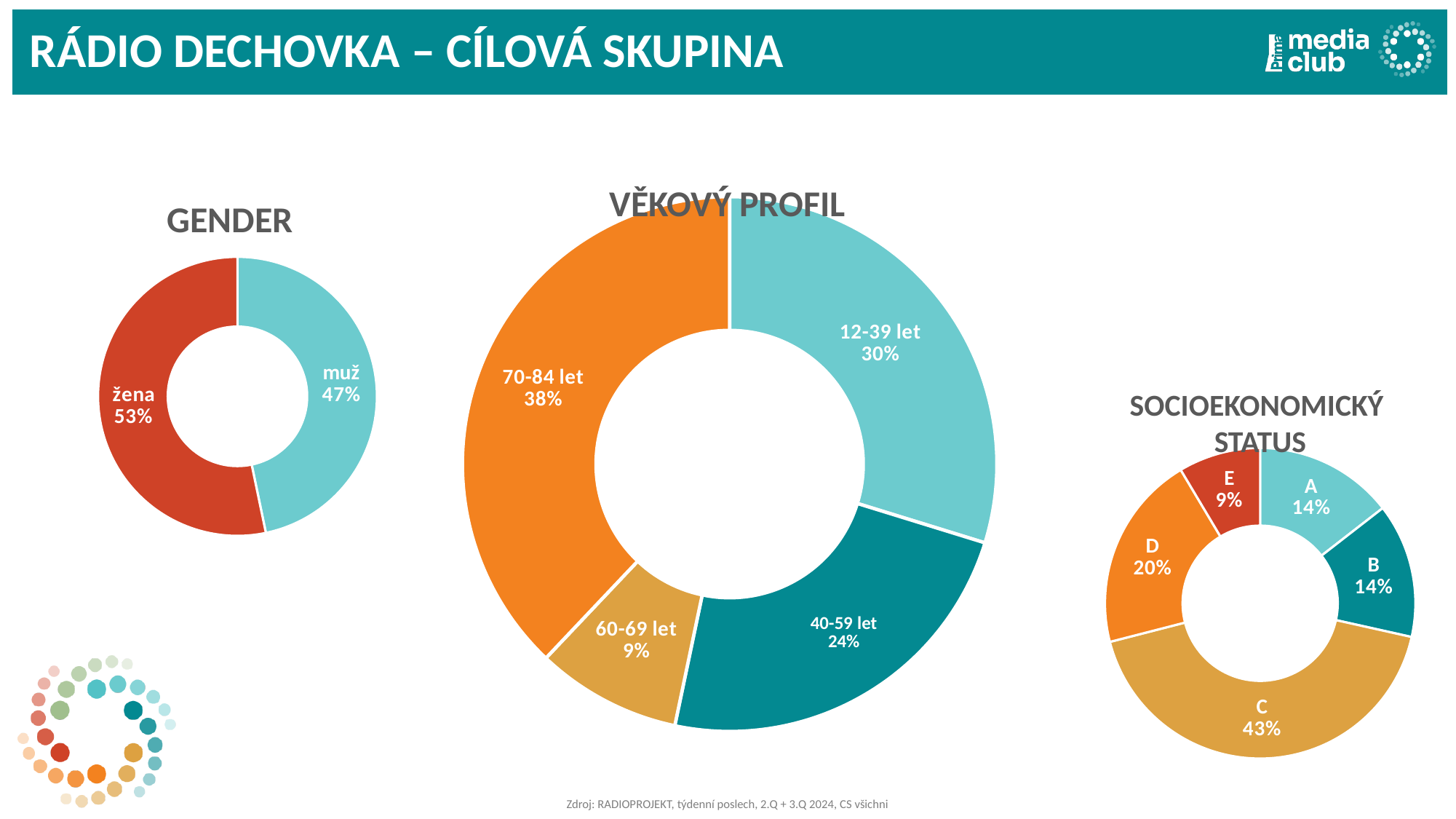
In the GENDER chart, what is the share for žena? 53% In the VĚKOVÝ PROFIL chart, which age group has the smallest share? 60-69 let How many age groups are shown in the VĚKOVÝ PROFIL chart? 4 In the SOCIOEKONOMICKÝ STATUS chart, which category has the smallest share? E What kind of chart is the GENDER chart? Doughnut (pie) chart In the GENDER chart, which category has the larger share, muž or žena? žena In the VĚKOVÝ PROFIL chart, what is the share for 40-59 let? 24% In the SOCIOEKONOMICKÝ STATUS chart, what is the difference between the shares for C and D? 23% In the VĚKOVÝ PROFIL chart, what is the difference between the shares for 70-84 let and 12-39 let? 8% In the SOCIOEKONOMICKÝ STATUS chart, what is the share for D? 20% In the SOCIOEKONOMICKÝ STATUS chart, which category has the largest share? C In the VĚKOVÝ PROFIL chart, which age group has the largest share? 70-84 let